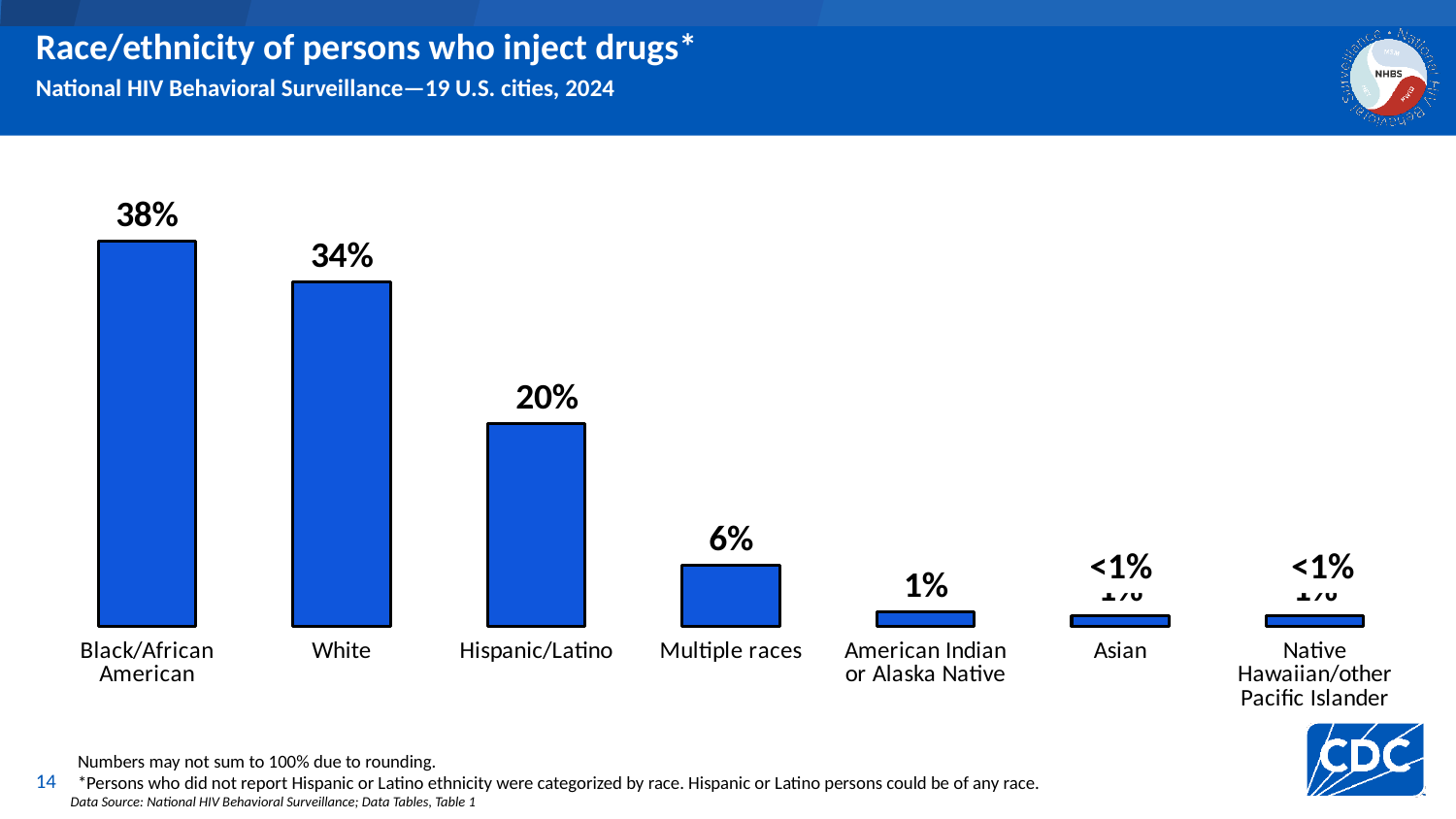
What type of chart is shown on the slide? Bar chart What value is shown for American Indian or Alaska Native? 1% What is the value for Multiple races? 6% What is the difference between the Hispanic/Latino and Multiple races values? 14% What percentage of persons who inject drugs are Black/African American? 38% Which is larger, the value for White or the value for Hispanic/Latino? White Which race/ethnicity category has the highest percentage? Black/African American What is the difference between the Black/African American and White percentages? 4% How many race/ethnicity categories are shown in the chart? 7 What value is shown for Asian? <1% What percentage is shown for Hispanic/Latino? 20% What is the value shown for White? 34%